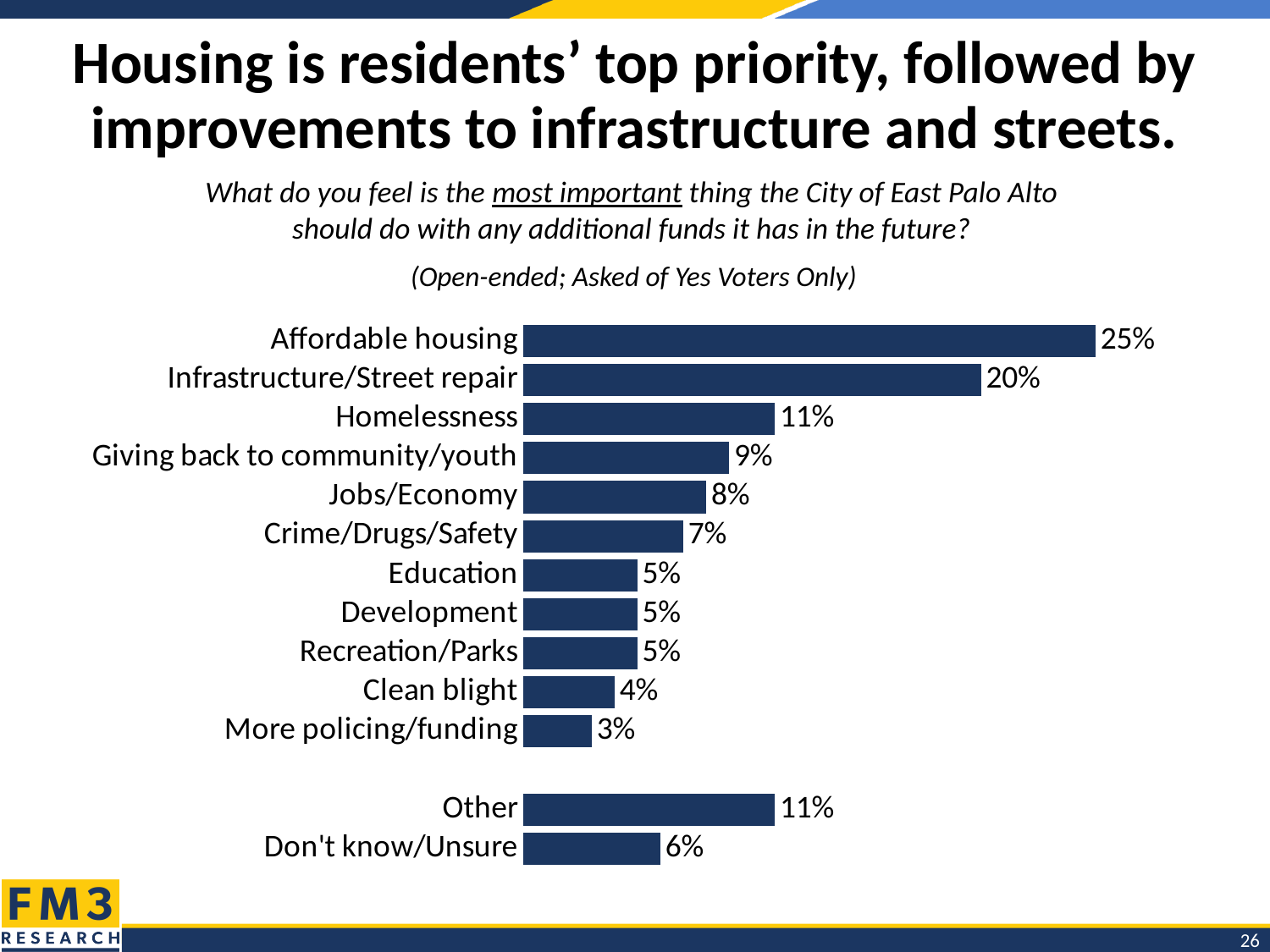
What kind of chart is shown on the slide? Bar chart What percentage of respondents named Affordable housing as the most important thing? 25% Which category has the highest value on the chart? Affordable housing Which is larger, the value for Crime/Drugs/Safety or the value for Education? Crime/Drugs/Safety How many categories share the value 5%? 3 What is the value shown for Infrastructure/Street repair? 20% What percentage is shown for Don't know/Unsure? 6% What is the difference between the values for Affordable housing and Infrastructure/Street repair? 5% What is the value for Clean blight? 4% What is the difference between the values for Homelessness and Jobs/Economy? 3% How many categories are plotted on the chart, including Other and Don't know/Unsure? 13 Which category has the lowest value on the chart? More policing/funding